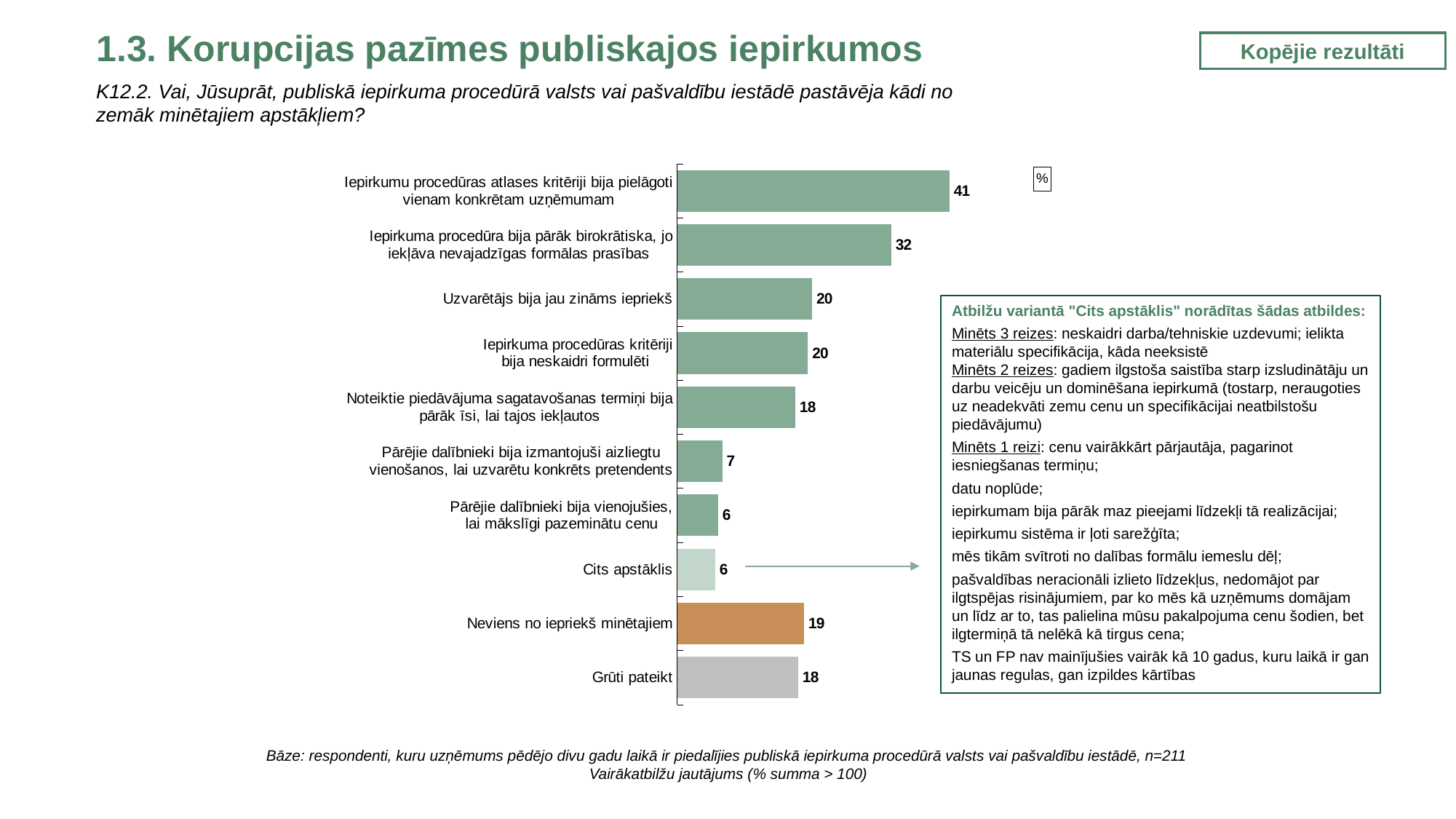
What is the value for "Cits apstāklis"? 6 What is the value for "Uzvarētājs bija jau zināms iepriekš"? 20 What percentage of respondents said "Iepirkumu procedūras atlases kritēriji bija pielāgoti vienam konkrētam uzņēmumam"? 41 Which category has the highest value in the chart? Iepirkumu procedūras atlases kritēriji bija pielāgoti vienam konkrētam uzņēmumam How many categories (bars) are shown in the chart? 10 What colour is the bar for "Neviens no iepriekš minētajiem"? Orange What is the value for "Pārējie dalībnieki bija izmantojuši aizliegtu vienošanos, lai uzvarētu konkrēts pretendents"? 7 What type of chart is shown on the slide? Bar chart What is the value for "Neviens no iepriekš minētajiem"? 19 What is the difference between the values for "Noteiktie piedāvājuma sagatavošanas termiņi bija pārāk īsi, lai tajos iekļautos" and "Pārējie dalībnieki bija vienojušies, lai mākslīgi pazeminātu cenu"? 12 Which is larger: the value for "Neviens no iepriekš minētajiem" or the value for "Grūti pateikt"? Neviens no iepriekš minētajiem What is the difference between the values for "Iepirkumu procedūras atlases kritēriji bija pielāgoti vienam konkrētam uzņēmumam" and "Iepirkuma procedūra bija pārāk birokrātiska, jo iekļāva nevajadzīgas formālas prasības"? 9